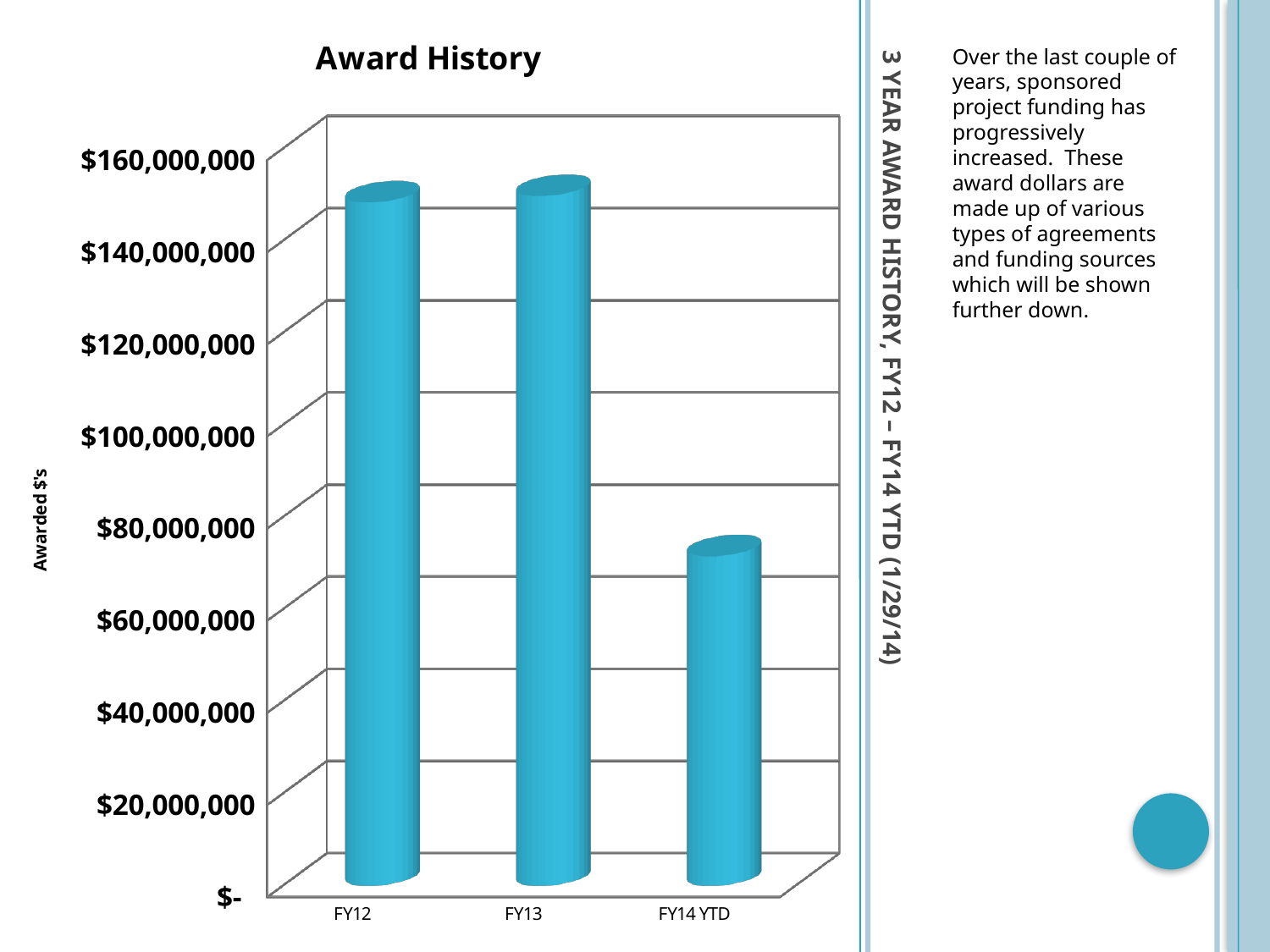
What is the title of the chart? Award History Which is larger, the value for FY12 or the value for FY14 YTD? FY12 Is the value for FY13 greater or less than $140,000,000? greater How many categories are shown on the x axis of the chart? 3 Is the value for FY14 YTD greater or less than $80,000,000? less What is the highest value shown on the vertical axis of the chart? $160,000,000 Which category has the lowest value in the chart? FY14 YTD Is the value for FY14 YTD greater or less than $60,000,000? greater What kind of chart is shown on the slide? bar chart What is the label on the vertical axis of the chart? Awarded $'s Which is larger, the value for FY13 or the value for FY14 YTD? FY13